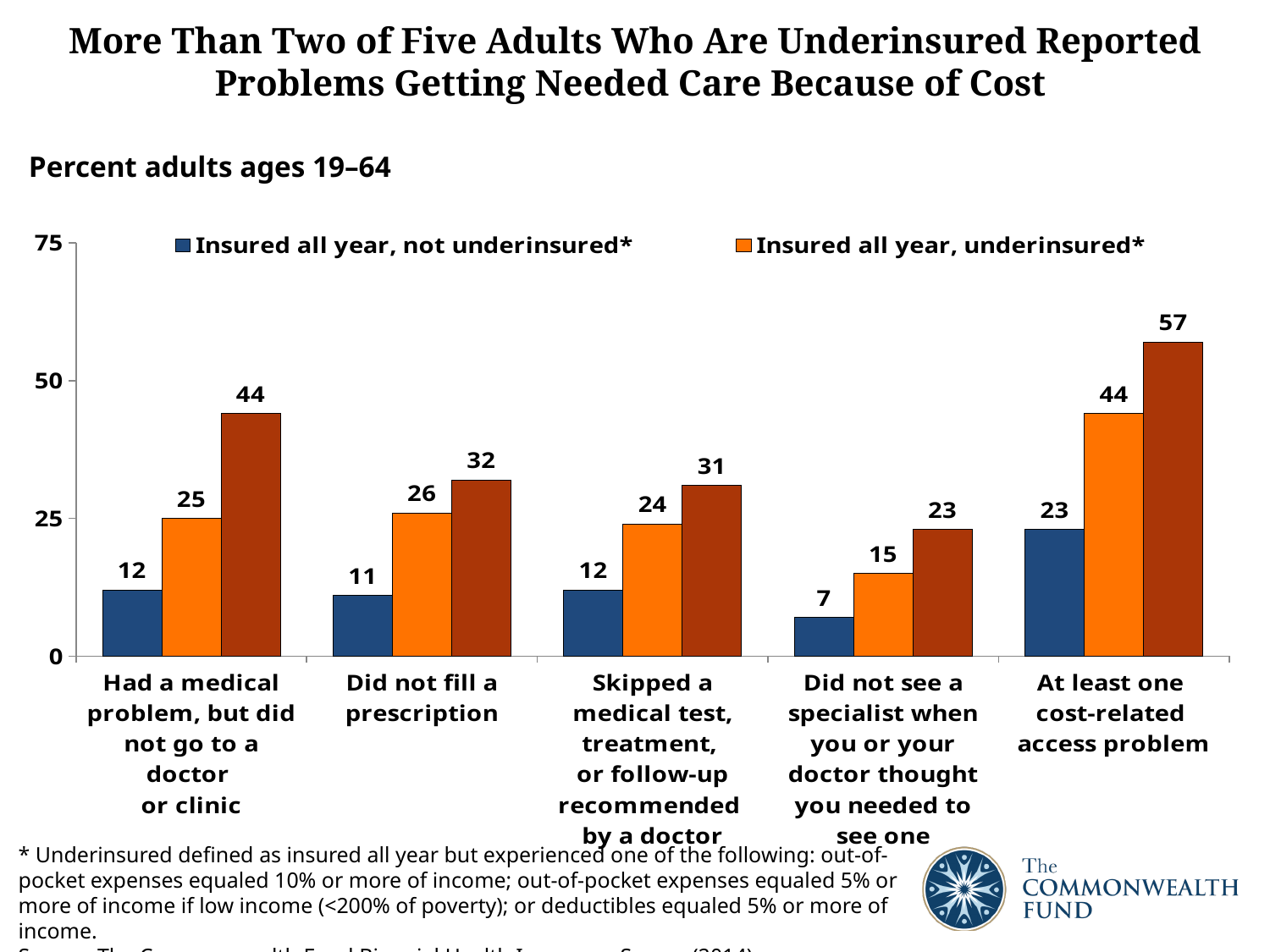
Which category has the lowest value for "Insured all year, not underinsured*"? Did not see a specialist when you or your doctor thought you needed to see one Which is larger: the "Insured all year, underinsured*" value for "Skipped a medical test, treatment, or follow-up recommended by a doctor" or for "Did not fill a prescription"? Did not fill a prescription What is the highest value printed on the chart? 57 Which category has the highest value for "Insured all year, underinsured*"? At least one cost-related access problem What is the value for "Insured all year, not underinsured*" in the "At least one cost-related access problem" category? 23 What is the value for "Insured all year, underinsured*" in the "Did not see a specialist when you or your doctor thought you needed to see one" category? 15 What is the label shown above the chart describing what the values represent? Percent adults ages 19–64 What kind of chart is shown on the slide? Bar chart How many categories are shown on the x axis? 5 What is the difference between the "Insured all year, underinsured*" and "Insured all year, not underinsured*" values in the "Had a medical problem, but did not go to a doctor or clinic" category? 13 What is the value for "Insured all year, underinsured*" in the "Did not fill a prescription" category? 26 How many series does the legend list? 2